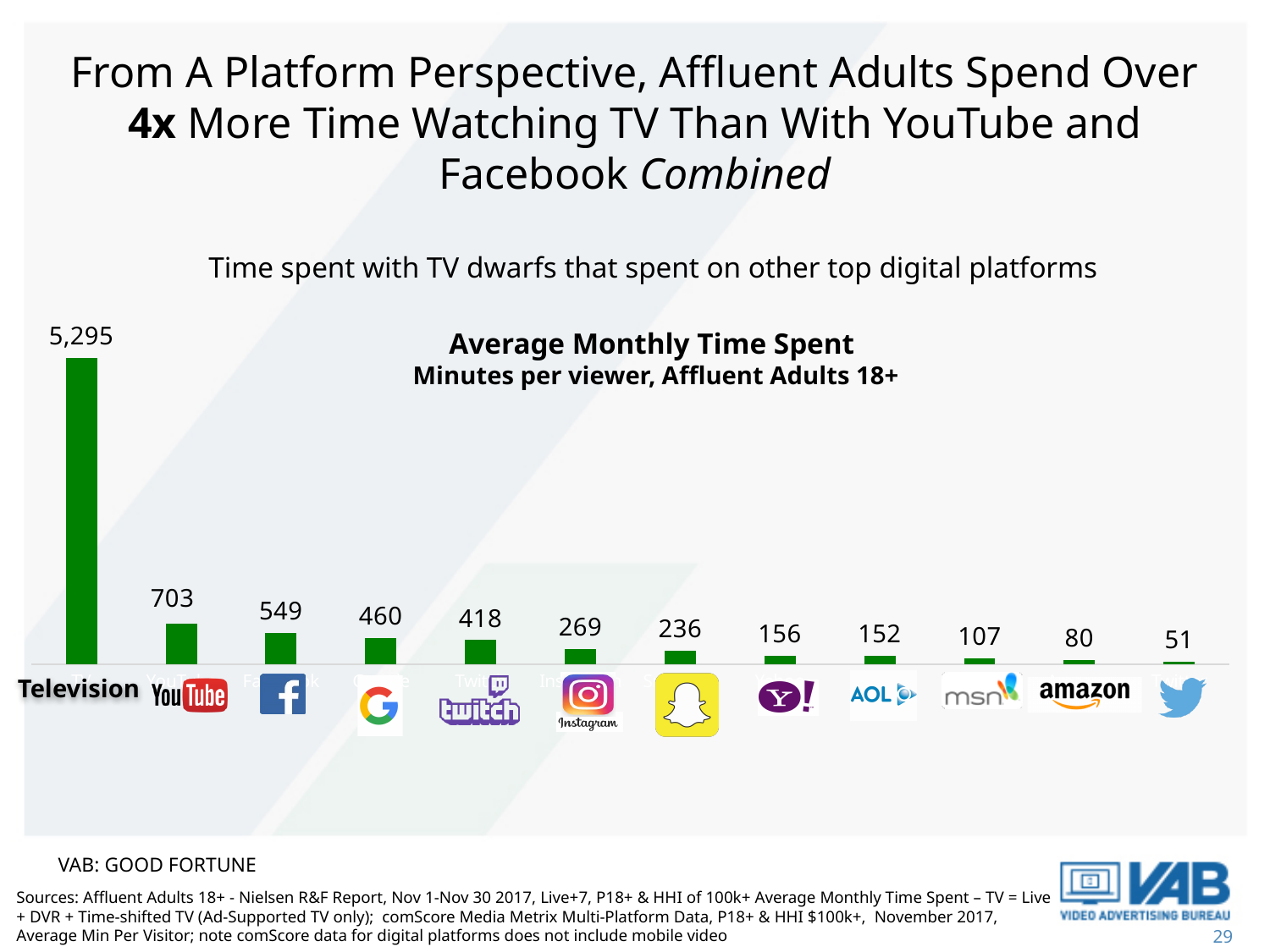
What is the combined value for YouTube and Facebook? 1,252 What is the difference between the values for YouTube and Facebook? 154 What is the value shown for Amazon? 80 Which platform has the lowest average monthly time spent? Twitter How many platforms are shown in the chart? 12 What is the title of the chart? Average Monthly Time Spent What is the value shown for Twitch? 418 What is the average monthly time spent for Television? 5,295 What is the value shown for YouTube? 703 Which platform has the highest average monthly time spent? Television What type of chart is shown on the slide? Bar chart Which has a larger value, Instagram or Snapchat? Instagram